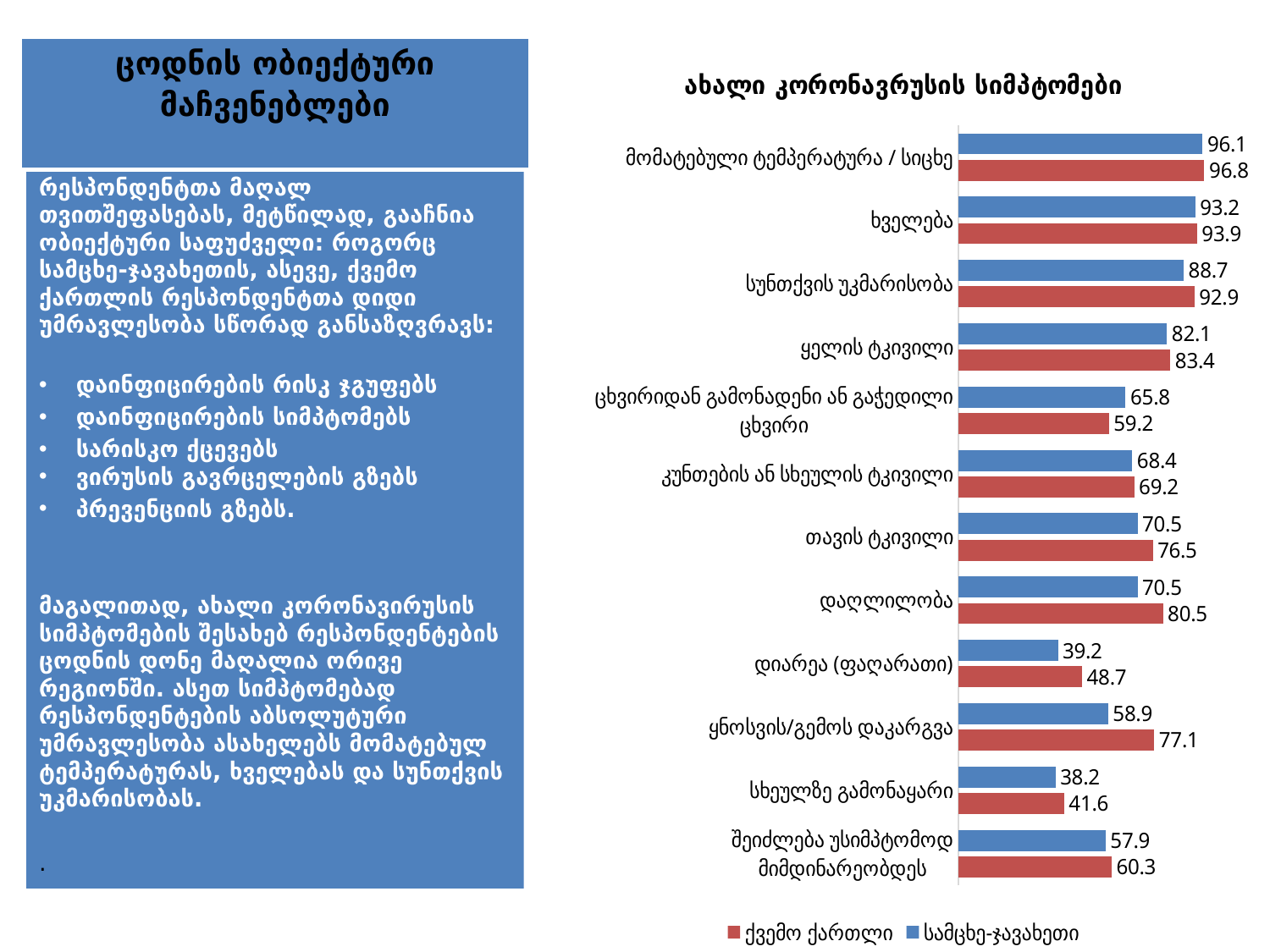
What is the difference between the ქვემო ქართლი and სამცხე-ჯავახეთი values for დაღლილობა? 10.0 What type of chart is shown on the slide? bar chart What is the value for ხველება in the ქვემო ქართლი series? 93.9 How many symptom categories are plotted in the chart? 12 What is the title of the chart? ახალი კორონავრუსის სიმპტომები Which category has the lowest value in the ქვემო ქართლი series? სხეულზე გამონაყარი What is the difference between the ქვემო ქართლი and სამცხე-ჯავახეთი values for ყნოსვის/გემოს დაკარგვა? 18.2 Which colour represents the ქვემო ქართლი series in the chart? red For ცხვირიდან გამონადენი ან გაჭედილი ცხვირი, which series has the larger value: ქვემო ქართლი or სამცხე-ჯავახეთი? სამცხე-ჯავახეთი How many series does the legend list? 2 Which category has the highest value in the სამცხე-ჯავახეთი series? მომატებული ტემპერატურა / სიცხე What is the value for სუნთქვის უკმარისობა in the სამცხე-ჯავახეთი series? 88.7